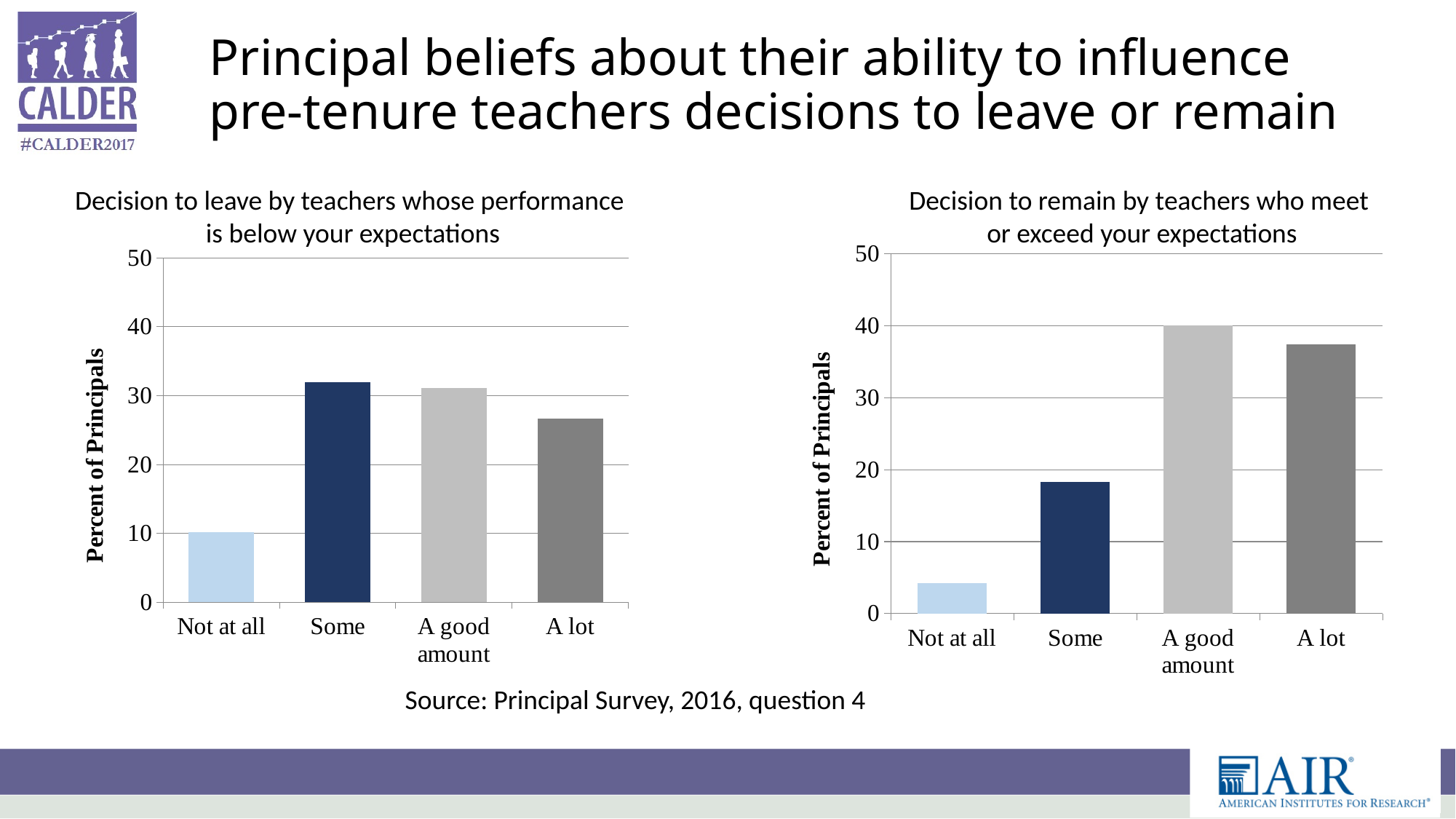
In the right chart (decision to remain), what is the value for 'A good amount'? 40 In the right chart (decision to remain), is the value for 'Some' greater or less than 20? less What is the y-axis label on the right chart (decision to remain)? Percent of Principals In the right chart (decision to remain), which category has the highest value? A good amount In the right chart (decision to remain), which is larger, the value for 'Some' or the value for 'A lot'? A lot In the left chart (decision to leave), how many categories are shown on the x axis? 4 What kind of chart is the left chart, 'Decision to leave by teachers whose performance is below your expectations'? Bar chart In the right chart (decision to remain), which category has the lowest value? Not at all In the left chart (decision to leave), is the value for 'Some' greater or less than 30? greater In the left chart (decision to leave), is the value for 'A lot' greater or less than 30? less In the left chart (decision to leave), which category has the lowest value? Not at all